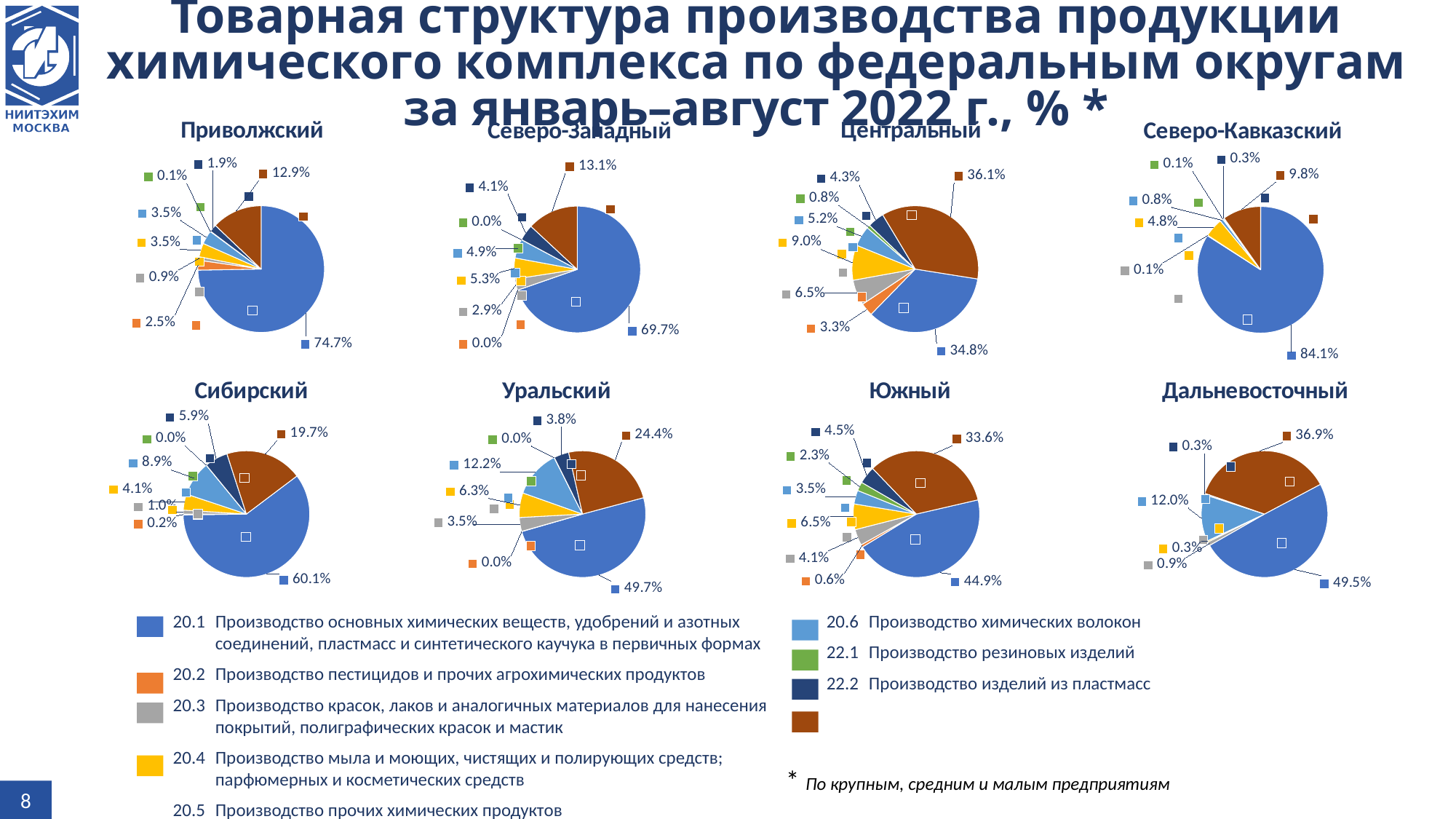
In the Сибирский pie chart, what is the difference between the blue slice (60.1%) and the brown slice (19.7%)? 40.4 percentage points Across all eight pie charts, which federal district has the highest share for category 20.1 (blue slice)? Северо-Кавказский In the Приволжский pie chart, what share is shown for category 20.1 (Производство основных химических веществ, удобрений и азотных соединений, пластмасс и синтетического каучука в первичных формах)? 74.7% In the Южный pie chart, what share is shown for category 20.4 (Производство мыла и моющих, чистящих и полирующих средств; парфюмерных и косметических средств)? 6.5% In the Северо-Кавказский pie chart, what share is shown for category 20.1 (the blue slice)? 84.1% How many pie charts are shown on the slide? 8 In the Уральский pie chart, what share is shown for category 20.6 (Производство химических волокон)? 12.2% In the Северо-Западный pie chart, what share is shown for category 20.3 (Производство красок, лаков и аналогичных материалов)? 2.9% In the Центральный pie chart, which is larger: the brown slice at 36.1% or the blue slice (category 20.1) at 34.8%? The brown slice at 36.1% In the Центральный pie chart, what is the largest share shown? 36.1% What type of chart is used to show the product structure for each federal district? Pie chart In the Дальневосточный pie chart, what share is shown for category 20.6 (Производство химических волокон)? 12.0%